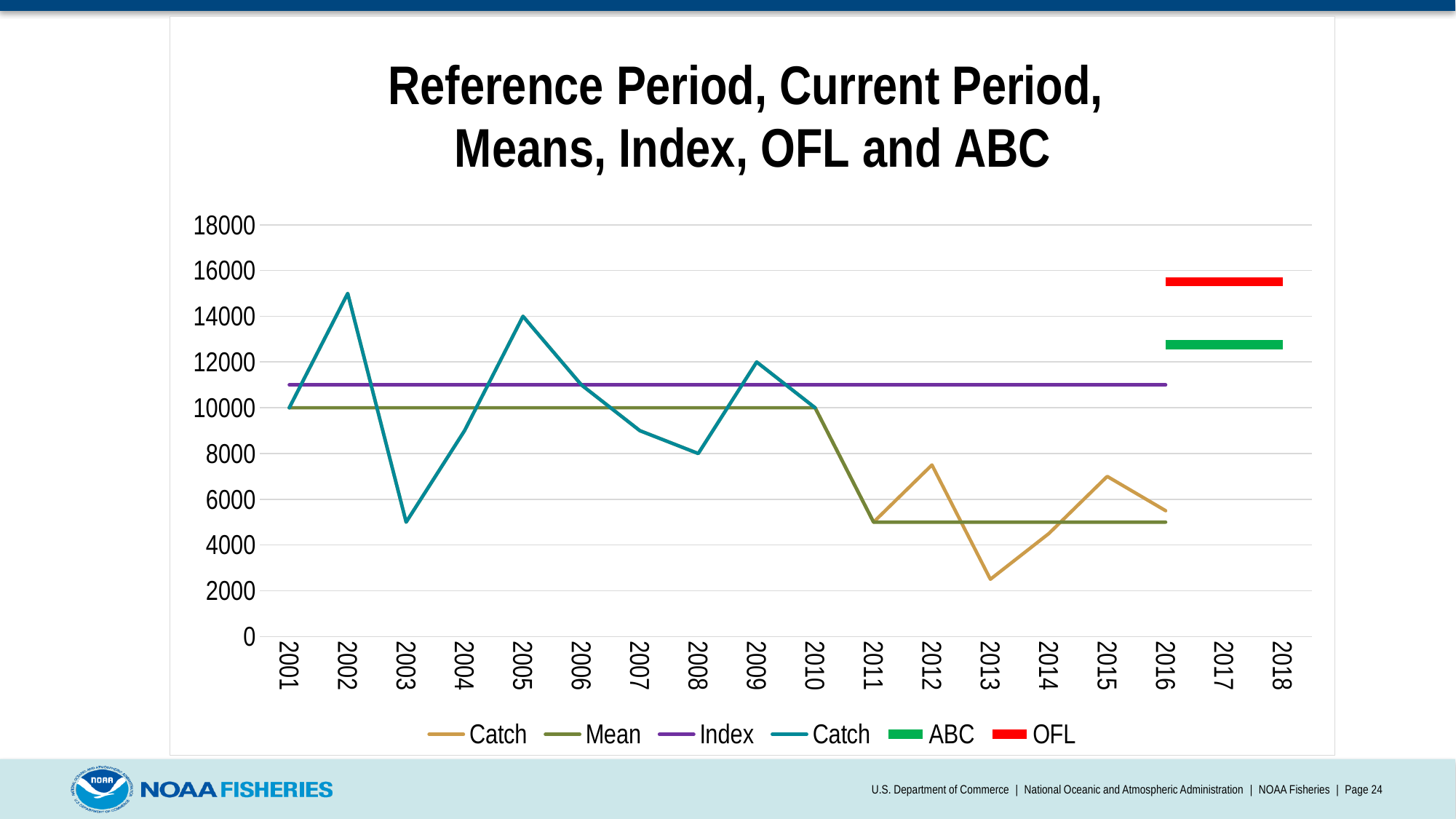
Does the Catch rise or fall from 2012 to 2013? fall What kind of chart is shown on the slide? line chart How many series does the legend list? 6 What is the Catch value in 2008? 8000 Is the Catch value for 2003 greater or less than 6000? less In which year is the Catch highest? 2002 What is the Catch value in 2005? 14000 Is the OFL value greater or less than 14000? greater In which year is the Catch lowest? 2013 How many years are labelled on the x axis? 18 What is the Catch value in 2009? 12000 Which is larger, the OFL or the ABC? OFL